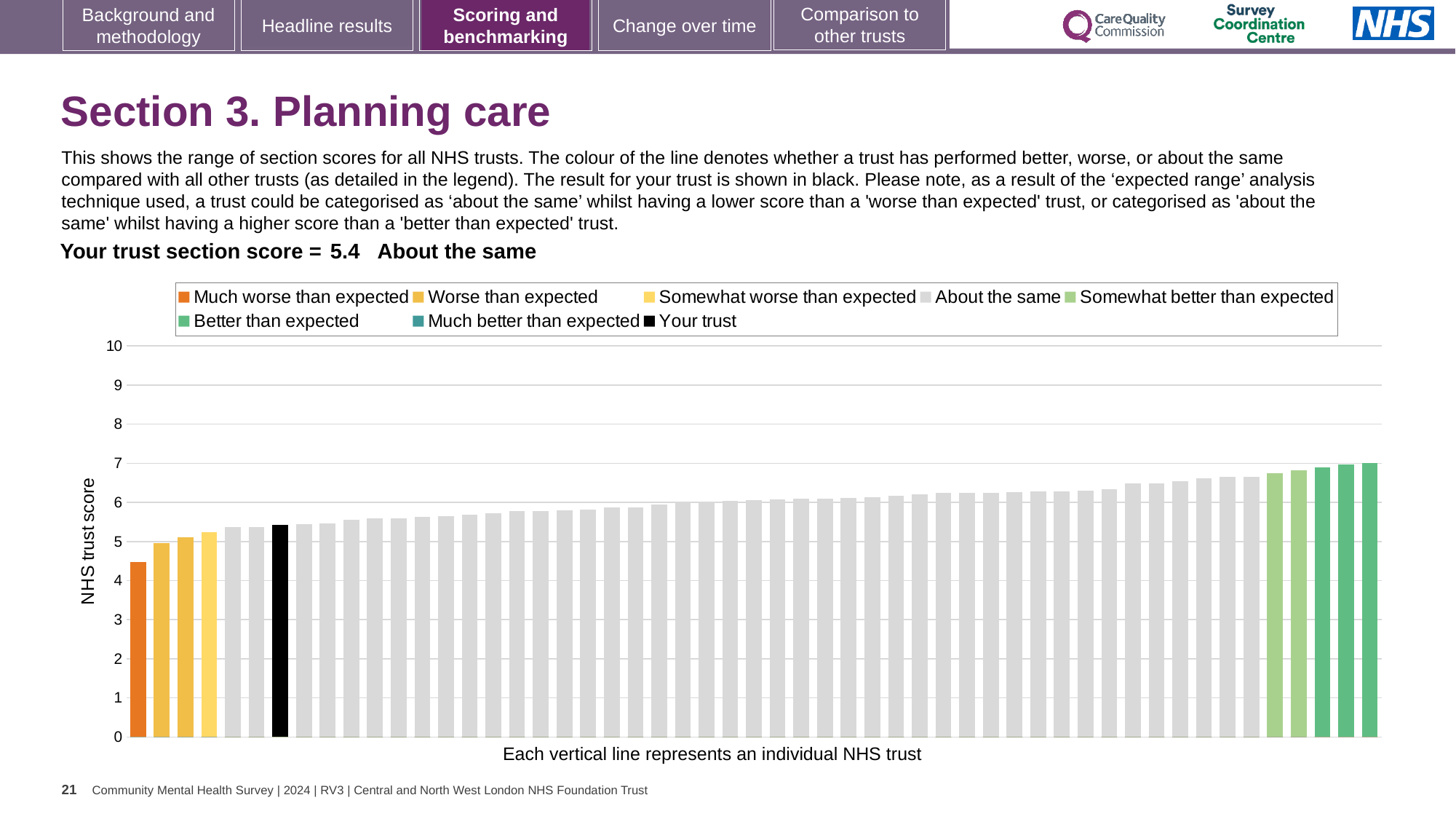
How many bars are coloured orange ('Much worse than expected')? 1 Is the value for your trust (the black bar) greater or less than 5? greater Which is larger: the orange 'Much worse than expected' bar or the black 'Your trust' bar? Your trust Which legend category does the lowest bar on the chart belong to? Much worse than expected Do the bar values rise or fall from left to right along the x axis? rise What is the label on the vertical axis of the chart? NHS trust score How many entries does the chart legend list? 8 Is the value of the highest bar on the right of the chart greater or less than 6? greater Is the value for your trust (the black bar) greater or less than 6? less What is the section score for your trust shown on the slide? 5.4 What kind of chart is shown on the slide? bar chart